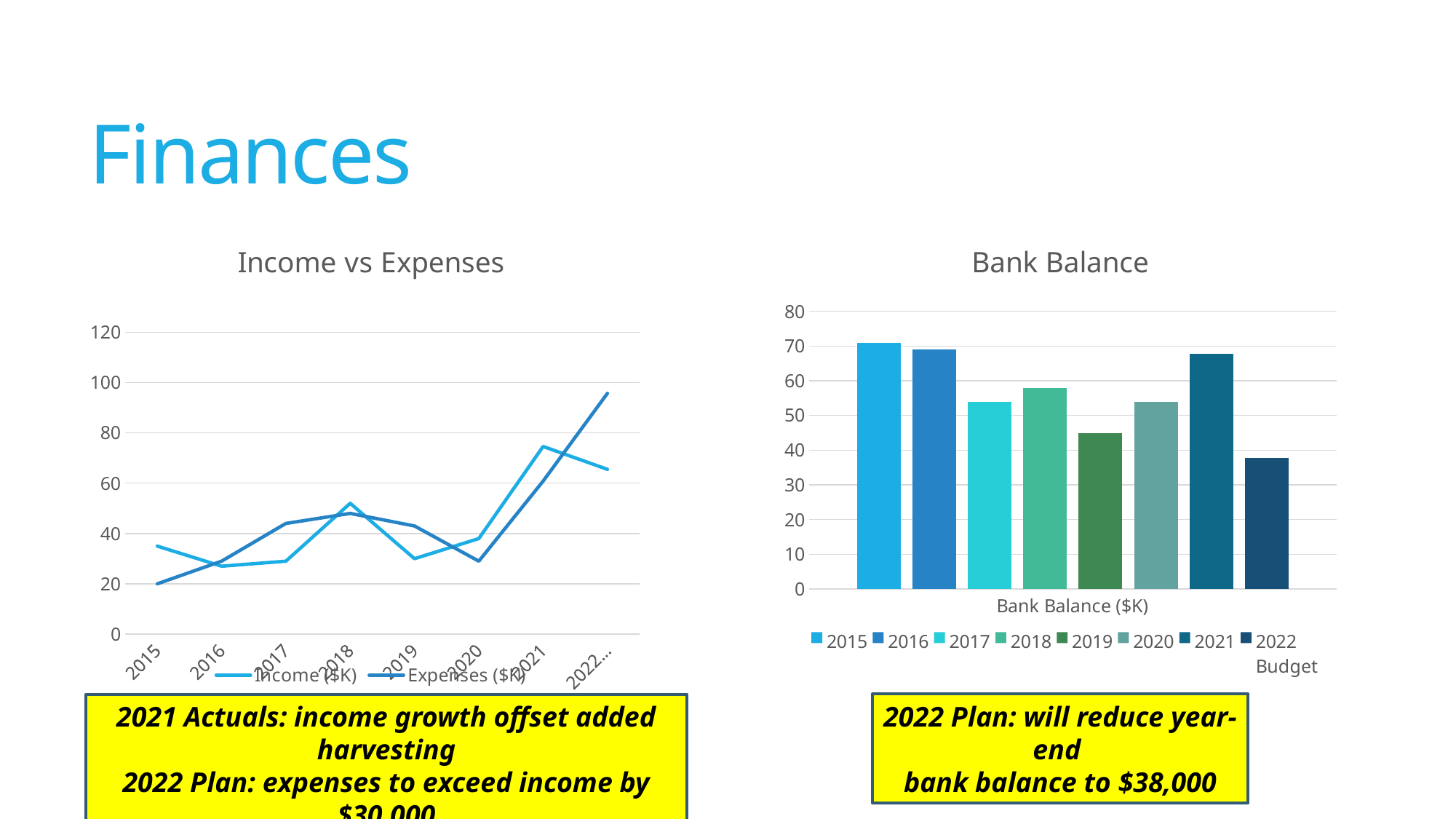
How many series does the legend of the "Income vs Expenses" chart list? 2 What kind of chart is the "Bank Balance" chart? bar chart In the "Bank Balance" chart, is the value for 2019 greater or less than 50? less In the "Bank Balance" chart, is the value for 2021 greater or less than 60? greater In the "Income vs Expenses" chart, which is larger in 2022: Income ($K) or Expenses ($K)? Expenses ($K) In the "Income vs Expenses" chart, do Expenses ($K) rise or fall from 2020 to 2022? rise In the "Bank Balance" chart, is the value for 2022 Budget greater or less than 40? less In the "Bank Balance" chart, which year has the lowest bank balance? 2022 Budget How many bars are shown in the "Bank Balance" chart? 8 What kind of chart is the "Income vs Expenses" chart? line chart